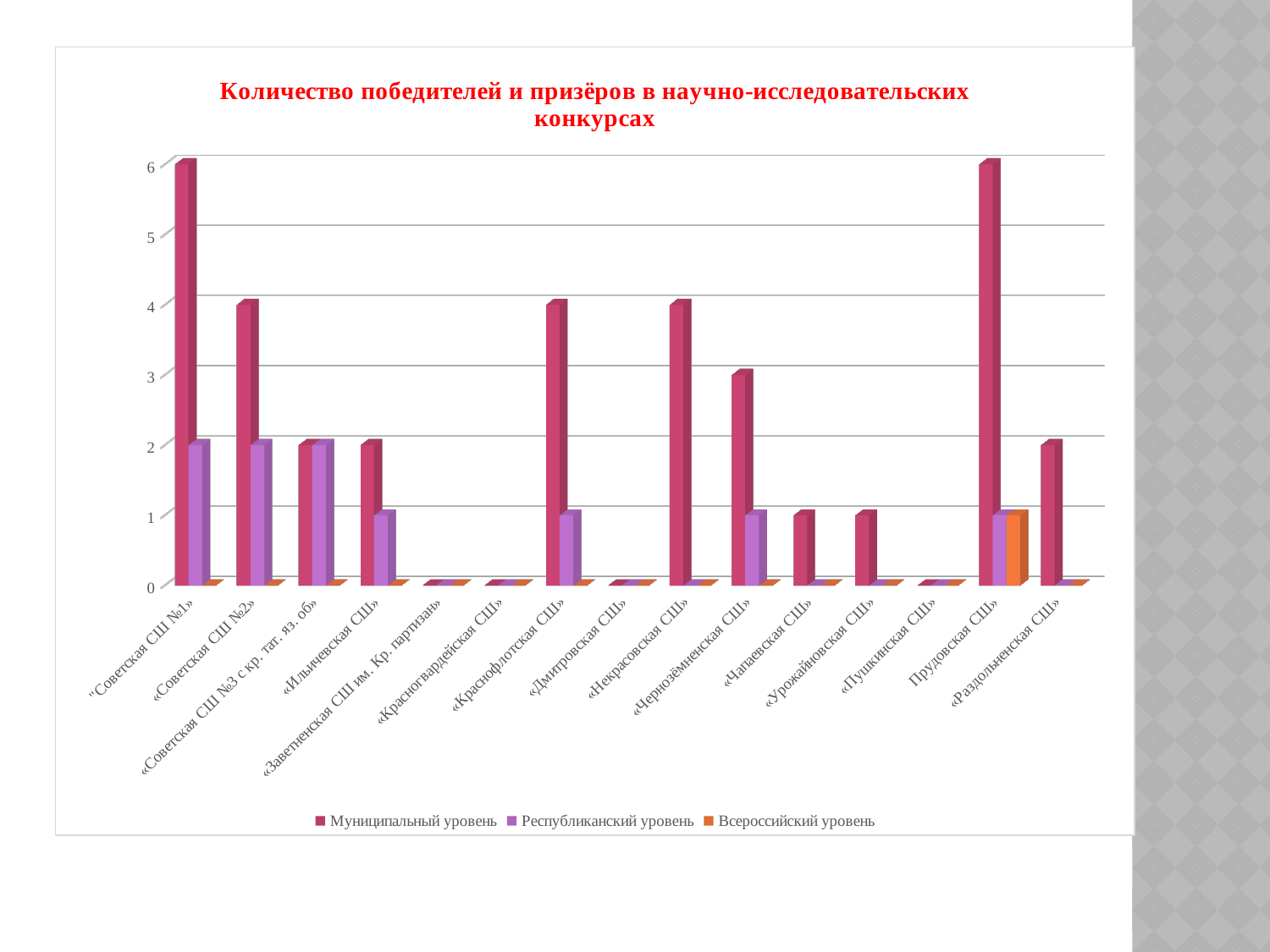
Which school is the only one with a non-zero value for Всероссийский уровень? «Прудовская СШ» What is the value of Всероссийский уровень for «Прудовская СШ»? 1 How many schools (categories) are shown on the x axis? 15 How many series does the legend list? 3 Which is larger: the Муниципальный уровень value for «Некрасовская СШ» or for «Чапаевская СШ»? «Некрасовская СШ» Is the Муниципальный уровень value for «Краснофлотская СШ» greater or less than 3? greater What is the value of Муниципальный уровень for «Чернозёмненская СШ»? 3 What is the value of Республиканский уровень for «Ильичевская СШ»? 1 What is the title of the chart? Количество победителей и призёров в научно-исследовательских конкурсах What kind of chart is shown on the slide? bar chart What is the value of Муниципальный уровень for «Советская СШ №2»? 4 What is the difference between the Муниципальный уровень values for «Советская СШ №1» and «Раздольненская СШ»? 4